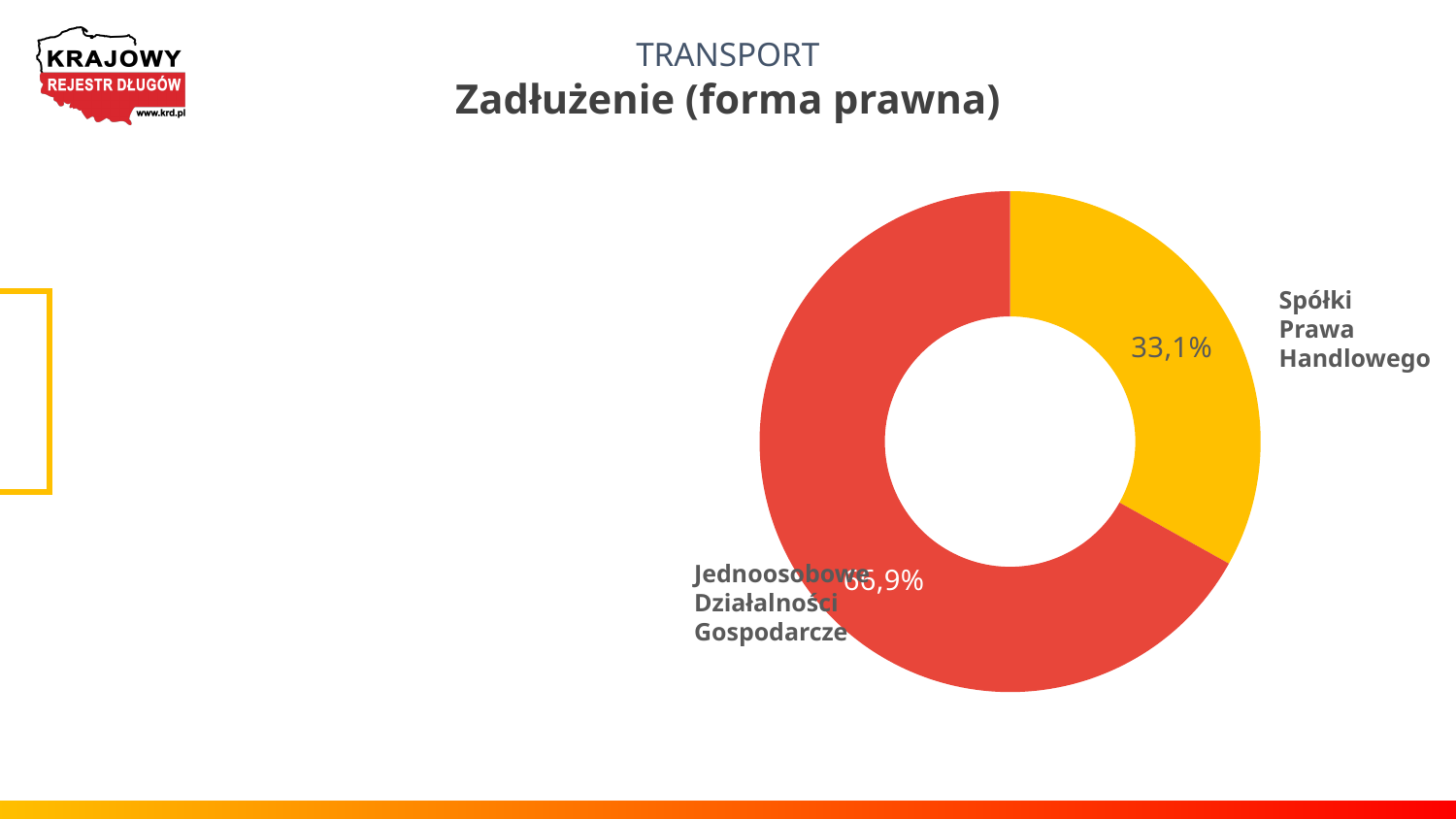
What is the title of the chart? Zadłużenie (forma prawna) How many categories are shown in the chart? 2 What kind of chart is shown on the slide? Pie chart (donut) Which category has the smallest share of the pie? Spółki Prawa Handlowego Which colour represents Spółki Prawa Handlowego in the chart? Yellow What share of the pie does Jednoosobowe Działalności Gospodarcze represent? 66,9% By how many percentage points does the share of Jednoosobowe Działalności Gospodarcze exceed that of Spółki Prawa Handlowego? 33,8 Which category has the largest share of the pie? Jednoosobowe Działalności Gospodarcze What share of the pie does Spółki Prawa Handlowego represent? 33,1% Which is larger: the share for Spółki Prawa Handlowego or the share for Jednoosobowe Działalności Gospodarcze? Jednoosobowe Działalności Gospodarcze